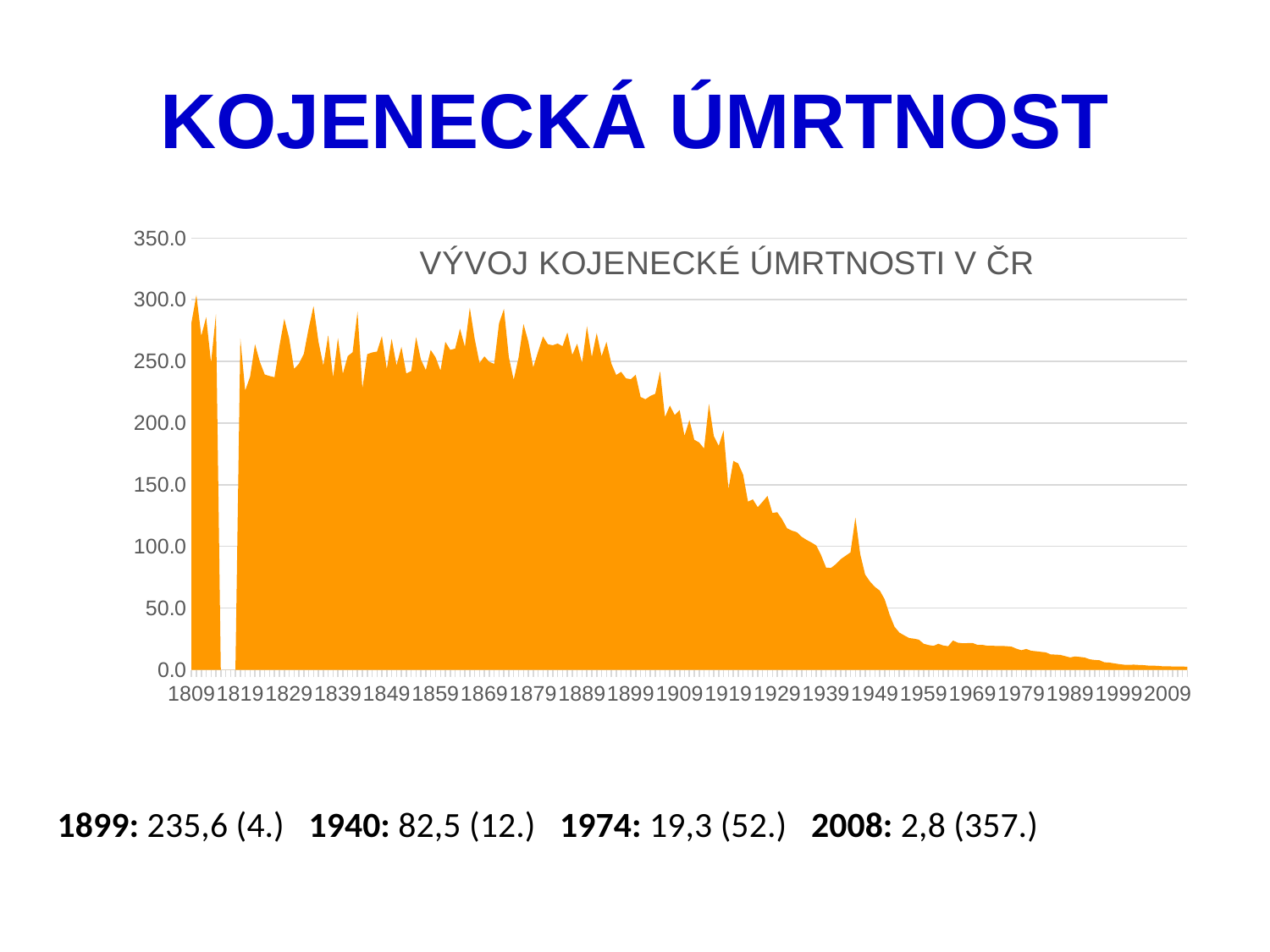
Which year had the higher infant mortality value, 1940 or 1974? 1940 Do the values in the chart generally rise or fall from 1809 to 2009? fall What kind of chart is shown on the slide? area chart What is the title of the chart? VÝVOJ KOJENECKÉ ÚMRTNOSTI V ČR Is the value for 1869 greater or less than 200? greater According to the slide, what was the infant mortality value in 2008? 2,8 What is the difference between the infant mortality values for 1899 and 2008 given on the slide? 232,8 What is the highest value shown on the vertical axis of the chart? 350.0 Is the value for 2009 greater or less than 50? less Is the value for 1929 greater or less than 100? greater According to the slide, what was the infant mortality value in 1899? 235,6